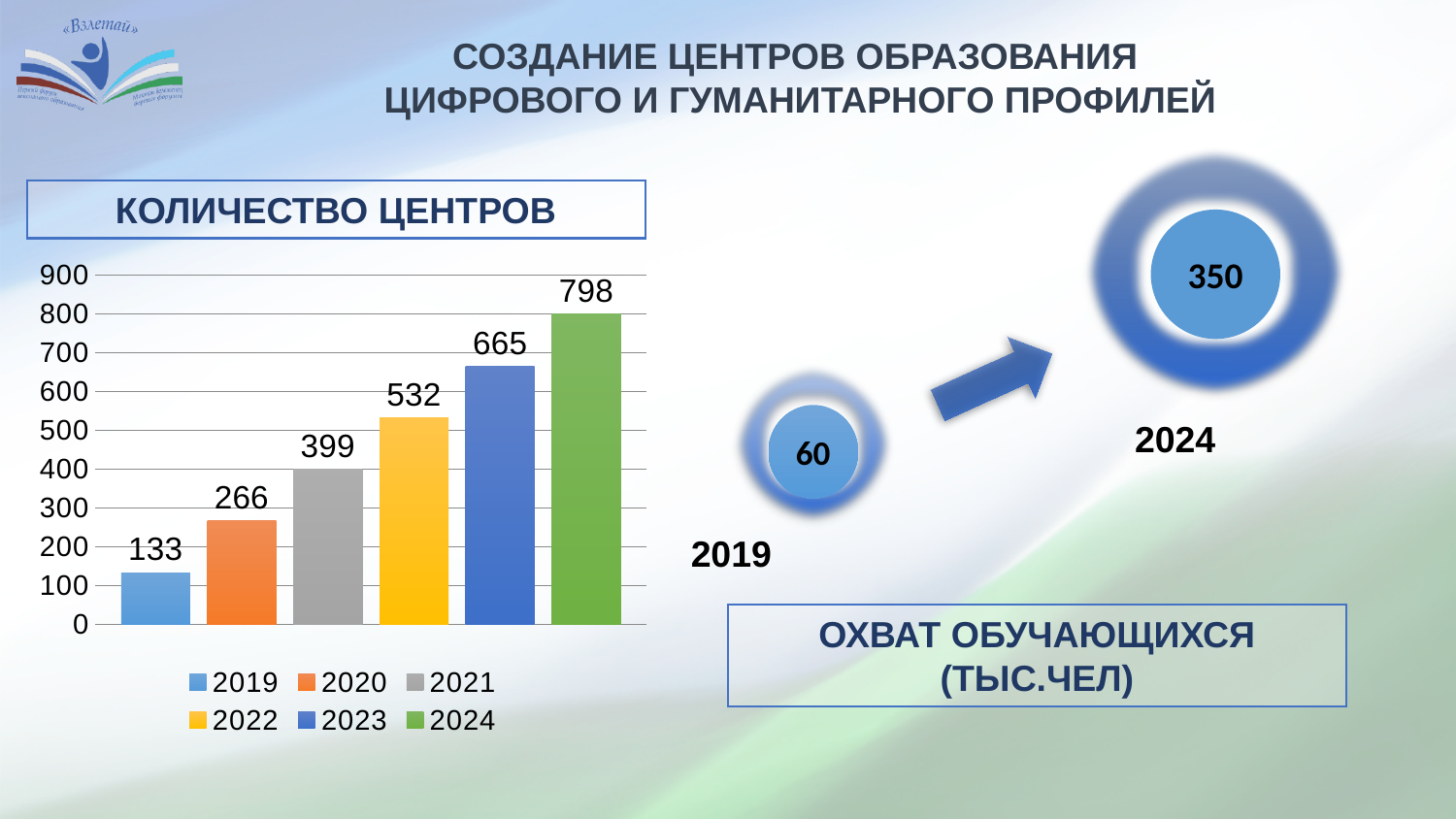
In the "КОЛИЧЕСТВО ЦЕНТРОВ" chart, what is the value for 2019? 133 In the "КОЛИЧЕСТВО ЦЕНТРОВ" chart, which year has the lowest value? 2019 In the "КОЛИЧЕСТВО ЦЕНТРОВ" chart, which is larger, the value for 2020 or the value for 2022? 2022 In the "КОЛИЧЕСТВО ЦЕНТРОВ" chart, which year has the highest value? 2024 How many bars are shown in the "КОЛИЧЕСТВО ЦЕНТРОВ" chart? 6 In the "КОЛИЧЕСТВО ЦЕНТРОВ" chart, what is the difference between the values for 2023 and 2022? 133 In the "КОЛИЧЕСТВО ЦЕНТРОВ" chart, is the value for 2023 greater or less than 600? greater In the "КОЛИЧЕСТВО ЦЕНТРОВ" chart, what is the difference between the values for 2024 and 2019? 665 In the "КОЛИЧЕСТВО ЦЕНТРОВ" chart, do the values rise or fall from 2019 to 2024? rise In the "КОЛИЧЕСТВО ЦЕНТРОВ" chart, what is the value for 2021? 399 In the "КОЛИЧЕСТВО ЦЕНТРОВ" chart, what is the value for 2024? 798 What kind of chart is the "КОЛИЧЕСТВО ЦЕНТРОВ" chart? bar chart